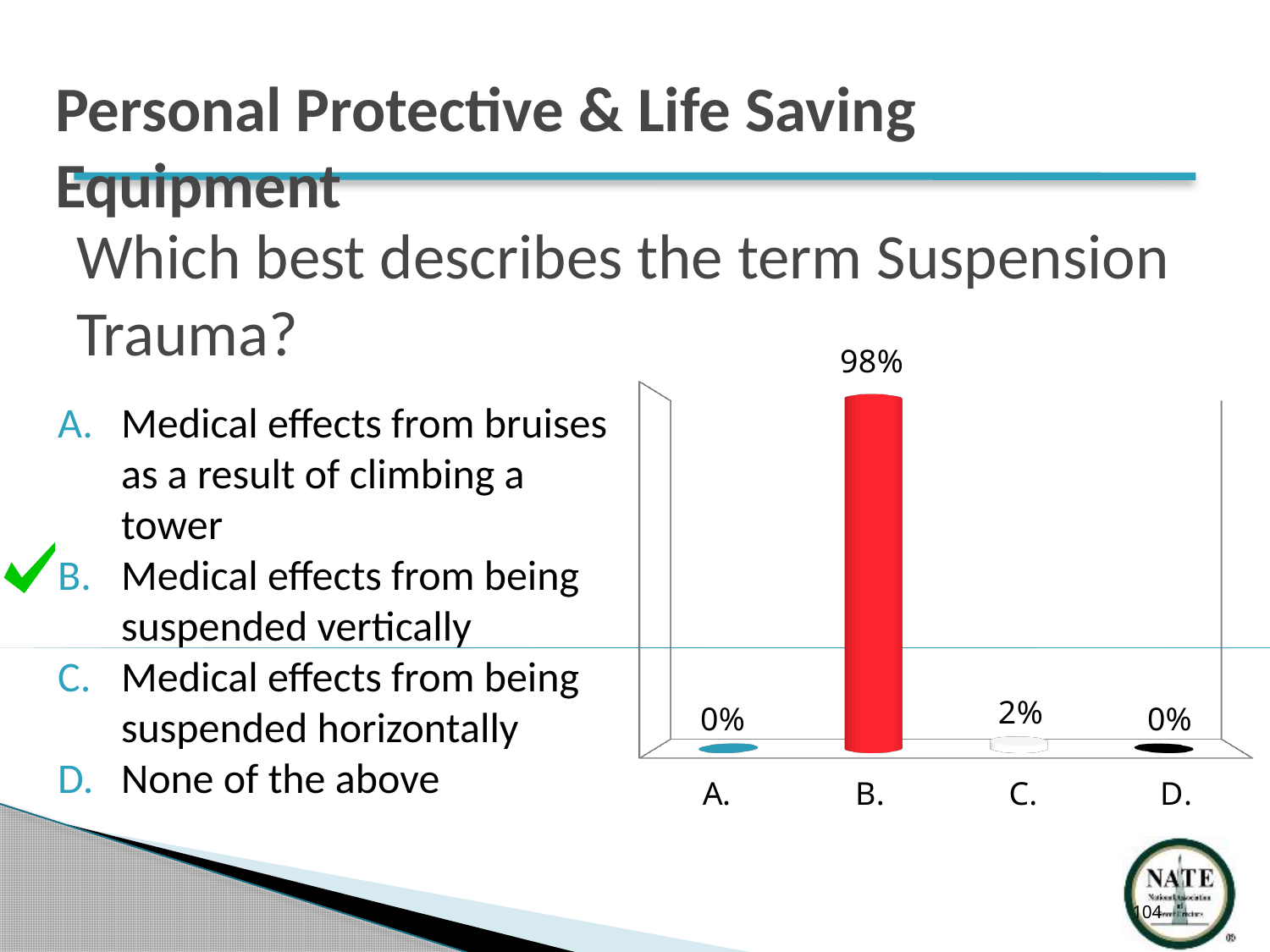
What is the value for category B.? 98% What is the total of the values for A., B., C. and D.? 100% What is the value for category D.? 0% What is the value for category A.? 0% What kind of chart is shown on the slide? bar chart Which category has the highest value? B. What colour is the bar for category B.? red What is the difference between the values for B. and C.? 96% Which is larger, the value for B. or the value for C.? B. What is the value for category C.? 2% Which category is marked with a check mark as the correct answer? B. How many categories are shown on the x axis? 4